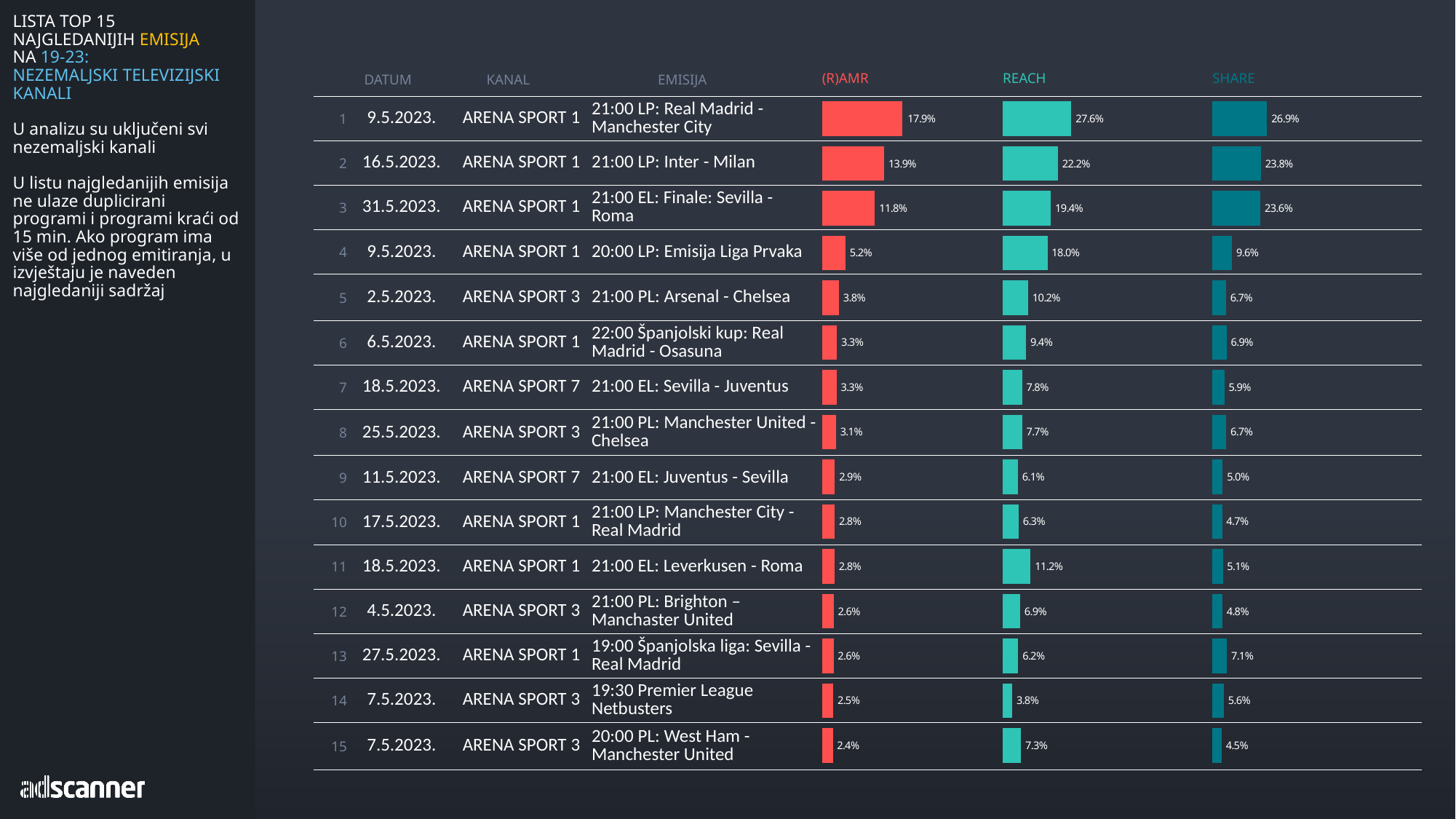
Which has a higher SHARE value: "21:00 LP: Inter - Milan" or "21:00 EL: Finale: Sevilla - Roma"? 21:00 LP: Inter - Milan What is the (R)AMR value for the programme "21:00 LP: Real Madrid - Manchester City"? 17.9% What kind of chart is used to visualise the (R)AMR, REACH and SHARE values? Bar chart How many programmes are listed in the table? 15 What is the REACH value for "21:00 EL: Leverkusen - Roma"? 11.2% What is the SHARE value for "21:00 EL: Finale: Sevilla - Roma"? 23.6% Which programme has the lowest REACH value? 19:30 Premier League Netbusters What is the difference between the (R)AMR values of "21:00 LP: Real Madrid - Manchester City" and "21:00 LP: Inter - Milan"? 4.0% Which has a higher REACH value: "21:00 EL: Leverkusen - Roma" or "21:00 PL: Arsenal - Chelsea"? 21:00 EL: Leverkusen - Roma What is the REACH value for "21:00 LP: Inter - Milan"? 22.2% Which programme has the highest (R)AMR value? 21:00 LP: Real Madrid - Manchester City How many bar series (metric columns) are shown in the table? 3